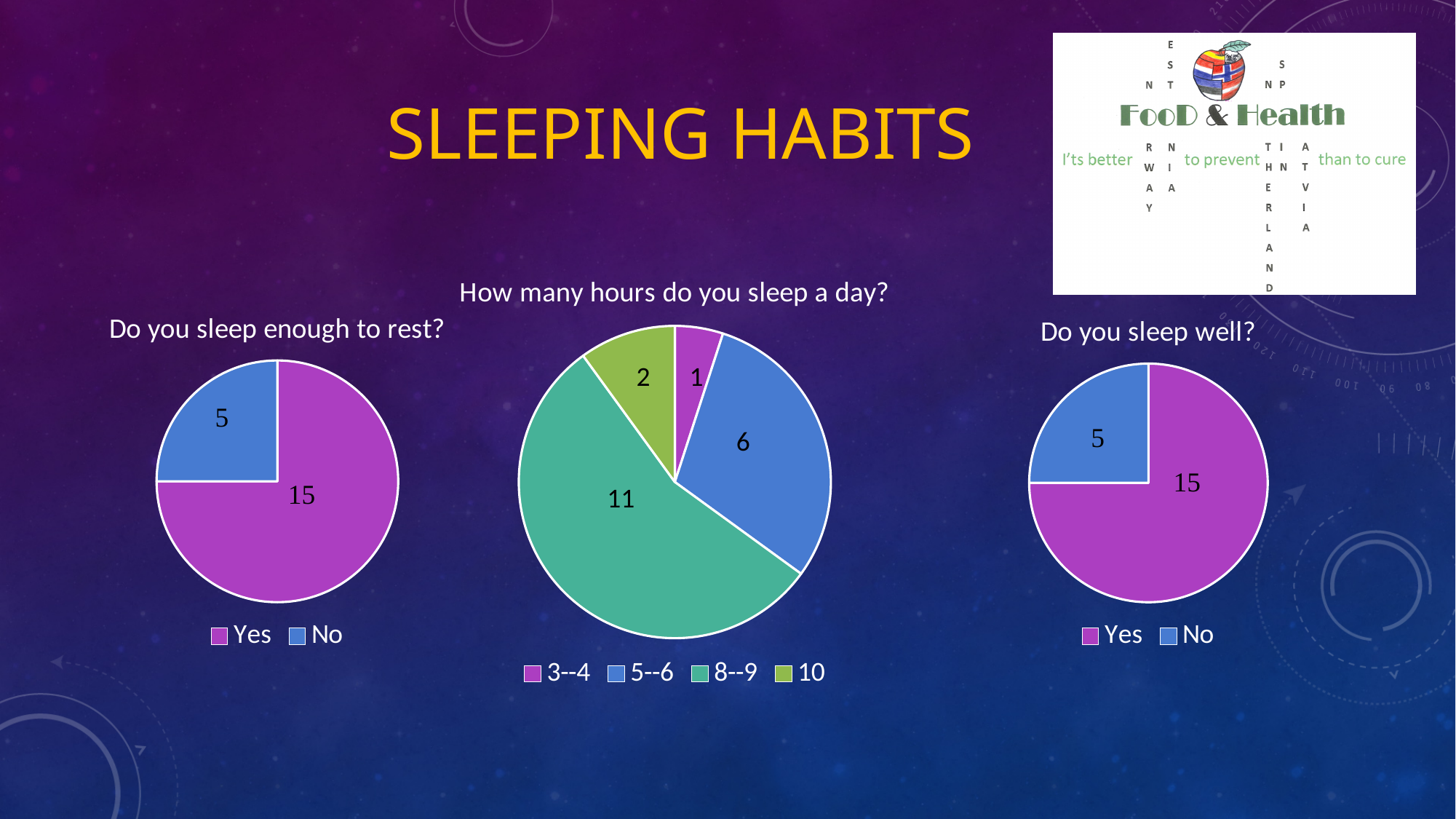
In the chart titled "Do you sleep enough to rest?", what is the value for Yes? 15 In the chart titled "Do you sleep well?", which is larger, Yes or No? Yes In the chart titled "How many hours do you sleep a day?", which category has the smallest slice? 3--4 In the chart titled "How many hours do you sleep a day?", what is the value for 5--6? 6 In the chart titled "How many hours do you sleep a day?", what is the value for 8--9? 11 In the chart titled "Do you sleep well?", what share of the pie does Yes represent? 75% In the chart titled "Do you sleep enough to rest?", what is the value for No? 5 In the chart titled "Do you sleep well?", what is the value for No? 5 In the chart titled "How many hours do you sleep a day?", what is the difference between the values for 8--9 and 5--6? 5 In the chart titled "How many hours do you sleep a day?", which category has the largest slice? 8--9 What kind of chart is used for "How many hours do you sleep a day?"? Pie chart In the chart titled "How many hours do you sleep a day?", how many categories does the legend list? 4